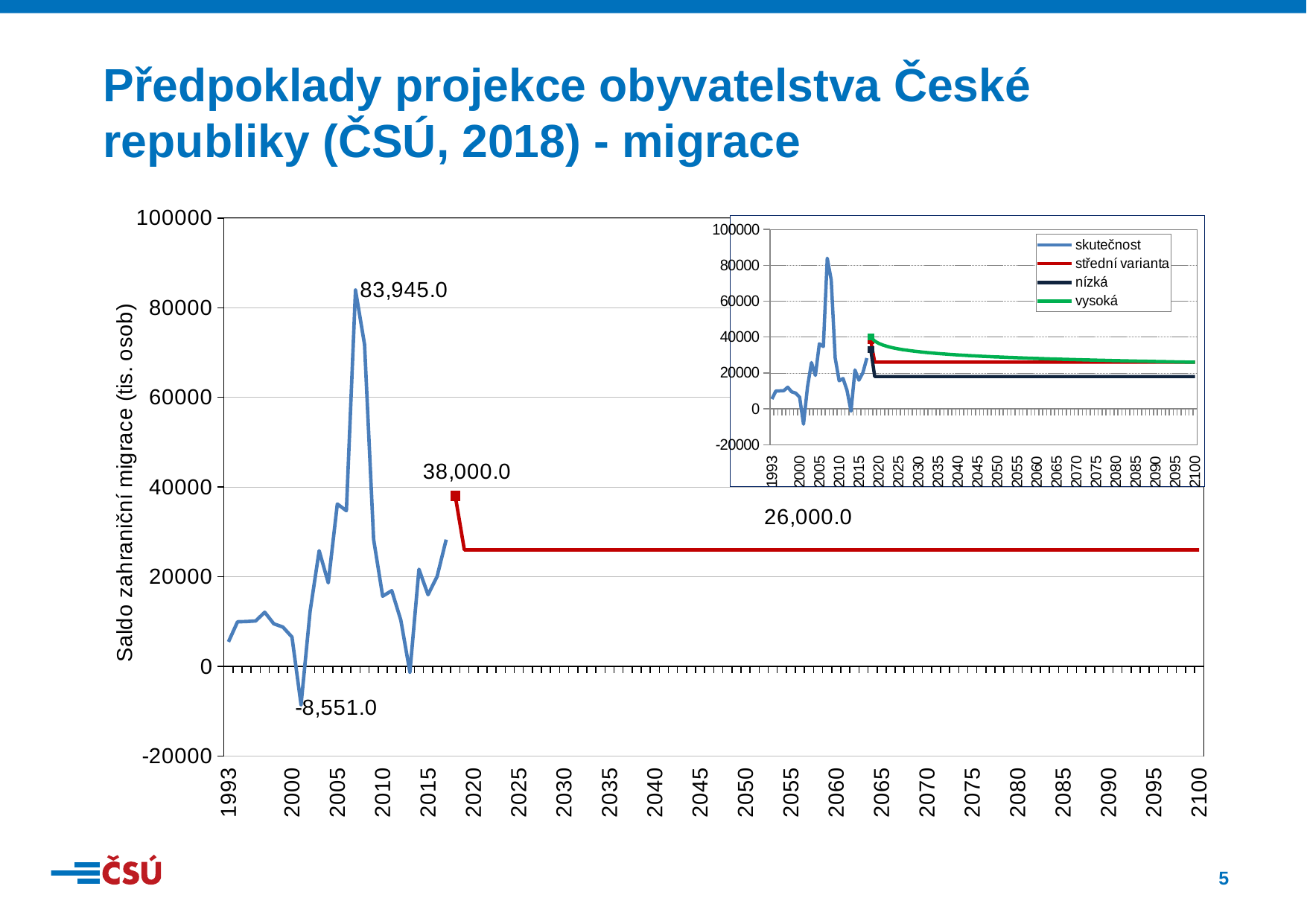
How many series does the legend of the small inset chart list? 4 On the large chart, what is the lowest labelled value of the blue line? -8,551.0 On the large chart, what value is labelled at the start of the red projection line? 38,000.0 What are the legend entries of the small inset chart? skutečnost, střední varianta, nízká, vysoká What is the y-axis label of the large chart? Saldo zahraniční migrace (tis. osob) On the large chart, what is the difference between the labelled values 38,000.0 and 26,000.0? 12,000.0 On the large chart, what is the highest labelled value of the blue line? 83,945.0 On the small inset chart, is the value of the vysoká series at 2100 greater or less than 20000? greater On the small inset chart, which series is higher at 2100, vysoká or nízká? vysoká What kind of chart is the large chart on the slide? line chart On the large chart, what value is labelled on the flat part of the red projection line? 26,000.0 On the large chart, what is the difference between the labelled peak value 83,945.0 and the long-run projection value 26,000.0? 57,945.0